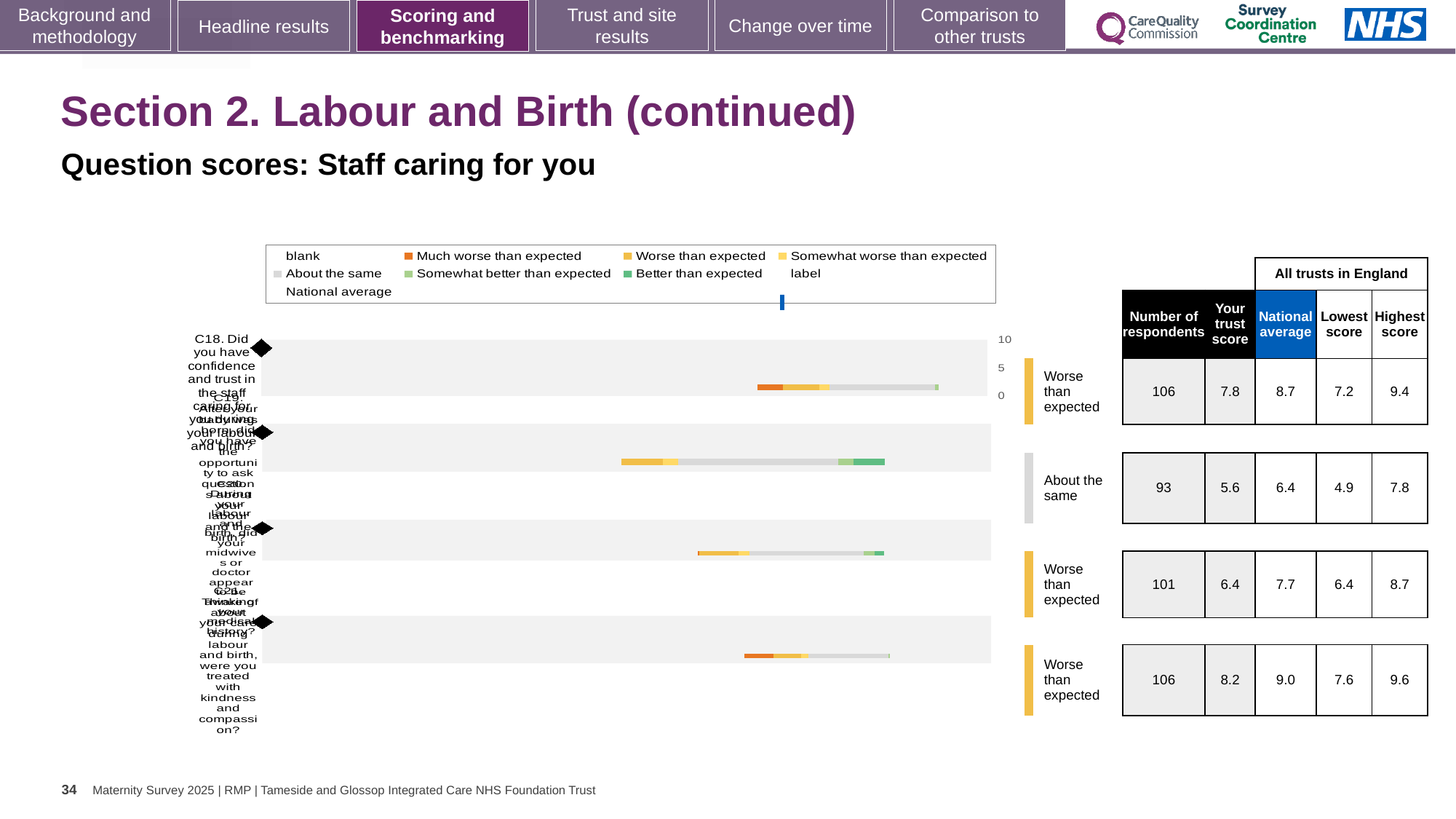
What kind of chart is shown on the slide? bar chart In the table beside the chart, what is the highest score for the fourth row (C21, treated with kindness and compassion)? 9.6 How many of the four rows are labelled 'Worse than expected'? 3 How many question bars are plotted in the chart? 4 In the table beside the chart, what is the national average for the second row? 6.4 What is the lowest score shown for the second row in the table? 4.9 In the table beside the chart, what is the number of respondents for the third row? 101 For the fourth row (C21), which is larger: the trust score or the national average? national average Which row in the table has the lowest 'Your trust score'? the second row, 5.6 For the first row (C18), what is the difference between the national average and the trust score? 0.9 Which row in the table has the highest 'Your trust score'? the fourth row (C21), 8.2 In the table beside the chart, what is the 'Your trust score' for the first row (C18, confidence and trust in staff)? 7.8